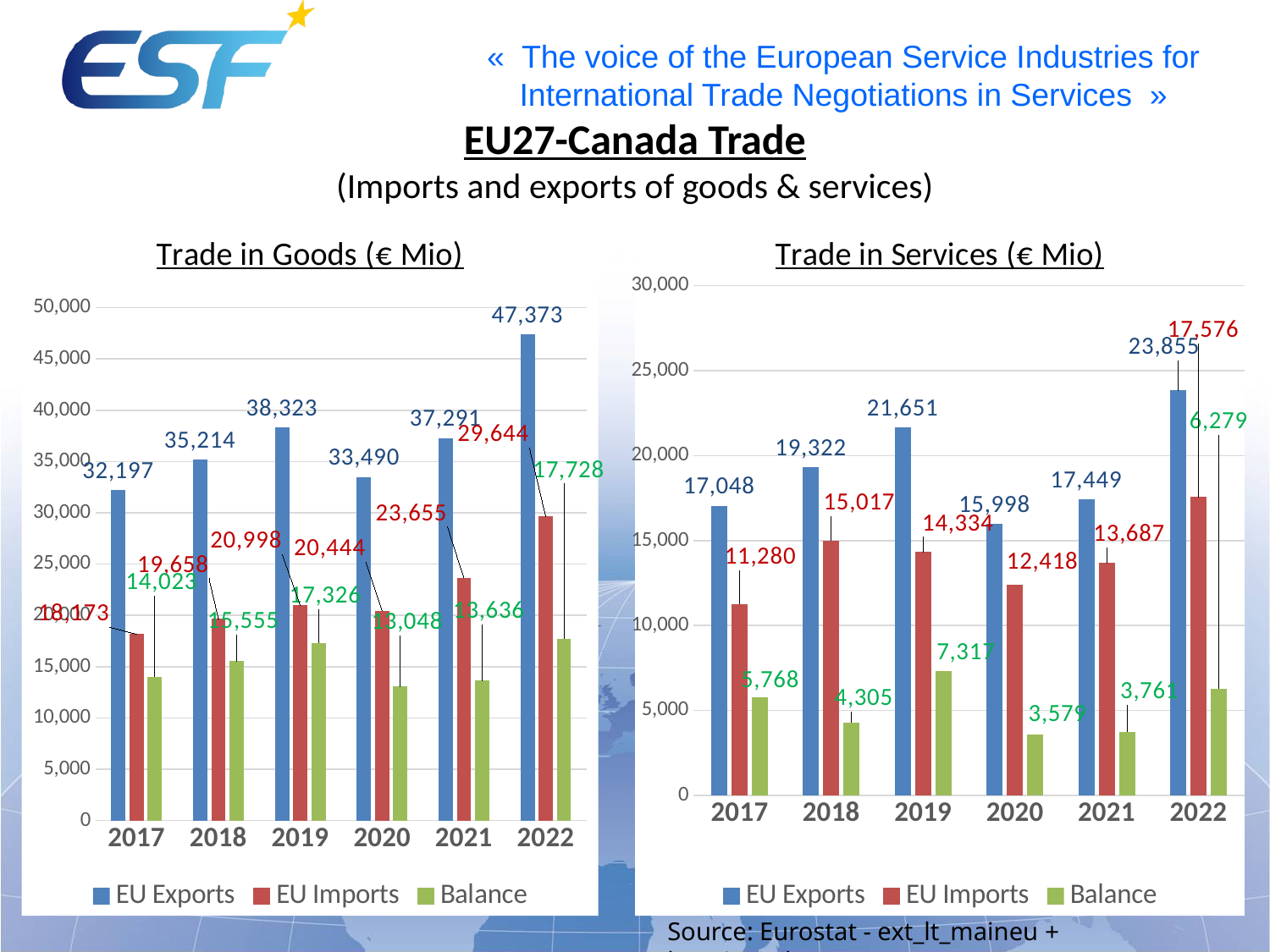
In the Trade in Goods (€ Mio) chart, which year has the highest EU Exports value? 2022 In the Trade in Services (€ Mio) chart, what is the value of EU Imports in 2018? 15,017 In the Trade in Services (€ Mio) chart, what is the Balance value for 2019? 7,317 How many years are shown on the x axis of the Trade in Services (€ Mio) chart? 6 In the Trade in Goods (€ Mio) chart, which colour represents the Balance series? Green How many series does the legend of the Trade in Goods (€ Mio) chart list? 3 In the Trade in Services (€ Mio) chart, which is larger: EU Exports in 2019 or EU Exports in 2021? EU Exports in 2019 In the Trade in Goods (€ Mio) chart, what is the value of EU Exports in 2022? 47,373 In the Trade in Goods (€ Mio) chart, what is the difference between EU Exports in 2022 and EU Exports in 2021? 10,082 In the Trade in Goods (€ Mio) chart, is the EU Imports value for 2022 greater or less than 25,000? greater What kind of chart is the Trade in Services (€ Mio) chart? Bar chart In the Trade in Services (€ Mio) chart, which year has the lowest Balance value? 2020